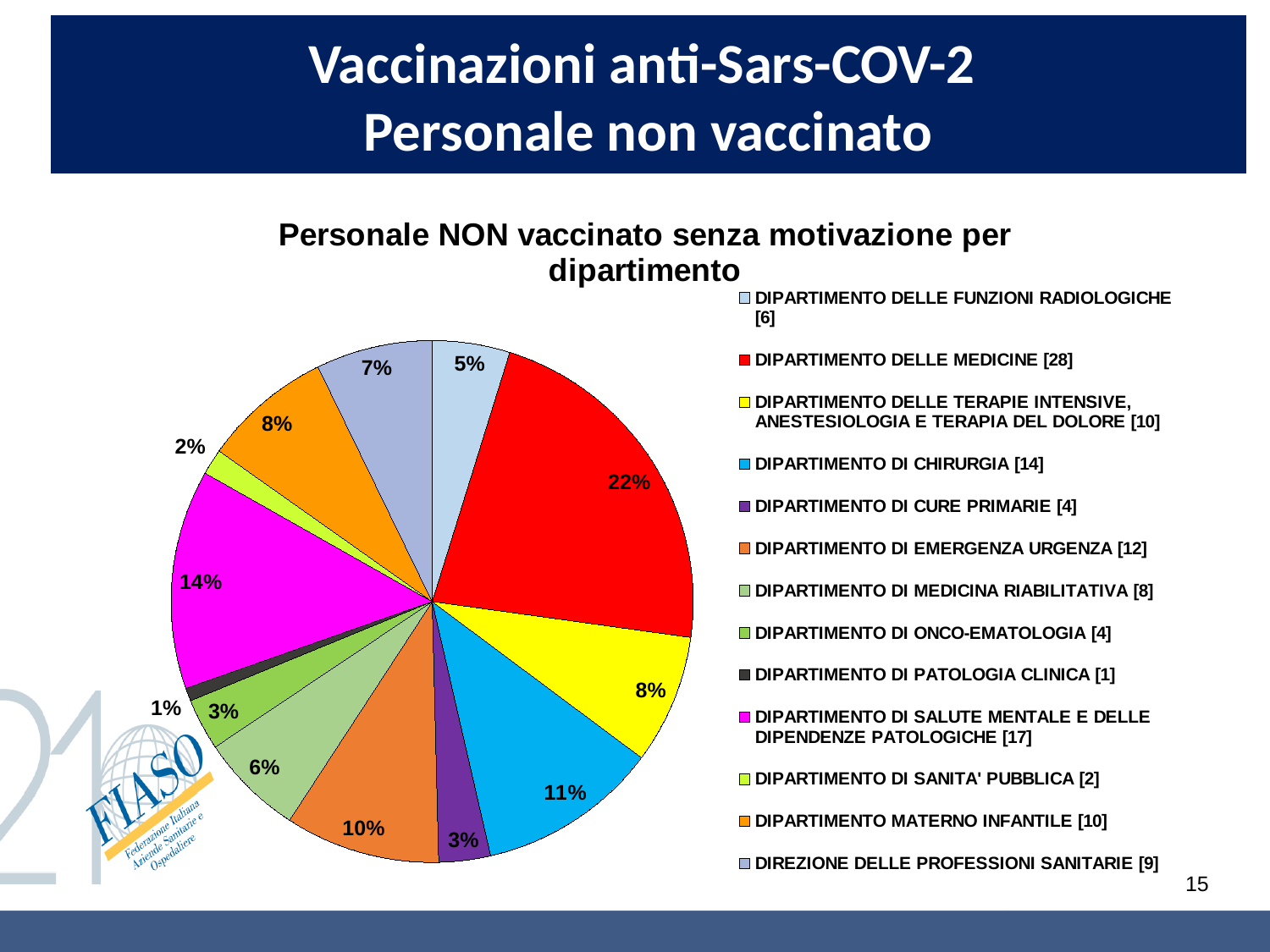
What kind of chart is shown on the slide? pie chart Which department has the smallest slice of the pie? DIPARTIMENTO DI PATOLOGIA CLINICA What share of the pie does DIPARTIMENTO DI CHIRURGIA represent? 11% What share of the pie does DIPARTIMENTO DI SALUTE MENTALE E DELLE DIPENDENZE PATOLOGICHE represent? 14% What share of the pie does DIPARTIMENTO DELLE MEDICINE represent? 22% How many slices does the pie chart have? 13 What is the difference in percentage points between the share of DIPARTIMENTO DELLE MEDICINE and the share of DIPARTIMENTO DI SALUTE MENTALE E DELLE DIPENDENZE PATOLOGICHE? 8% What is the title of the chart? Personale NON vaccinato senza motivazione per dipartimento Which has a larger share: DIPARTIMENTO DI EMERGENZA URGENZA or DIPARTIMENTO DI MEDICINA RIABILITATIVA? DIPARTIMENTO DI EMERGENZA URGENZA How many people are listed in the legend for DIPARTIMENTO DI EMERGENZA URGENZA? 12 Which department has the largest slice of the pie? DIPARTIMENTO DELLE MEDICINE How many people are listed in the legend for DIREZIONE DELLE PROFESSIONI SANITARIE? 9